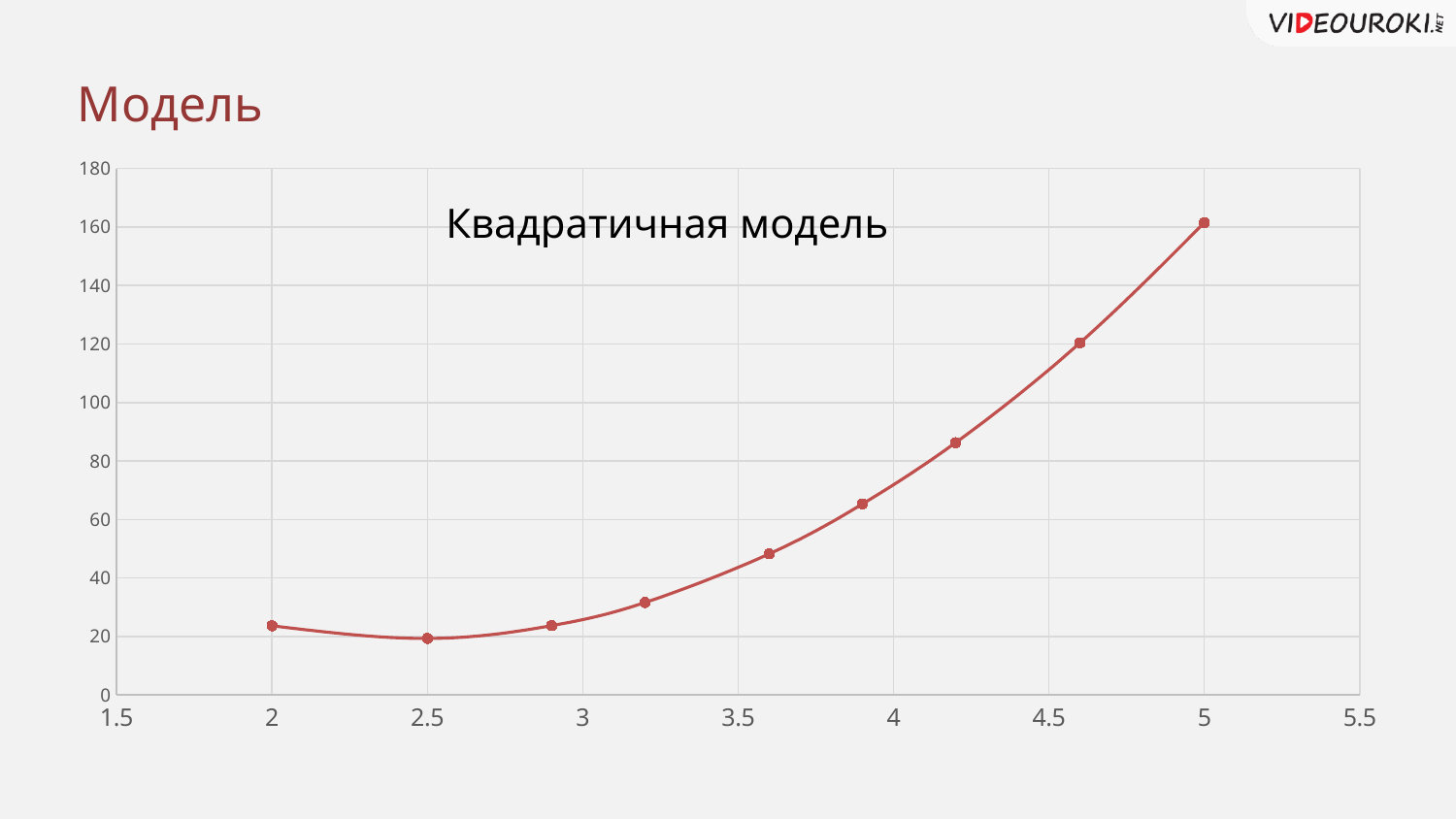
At which x value does the curve reach its highest point? 5 At which x value does the curve reach its lowest point? 2.5 Between x = 3 and x = 5, do the values rise or fall as x increases? rise What kind of chart is shown on the slide? line chart Which is larger: the value at x = 5 or the value at x = 2? x = 5 Is the value at x = 5 greater or less than 140? greater Is the value at x = 3.9 greater or less than 60? greater Is the value at x = 4.2 greater or less than 80? greater What is the title of the chart? Квадратичная модель How many data points are plotted on the chart? 9